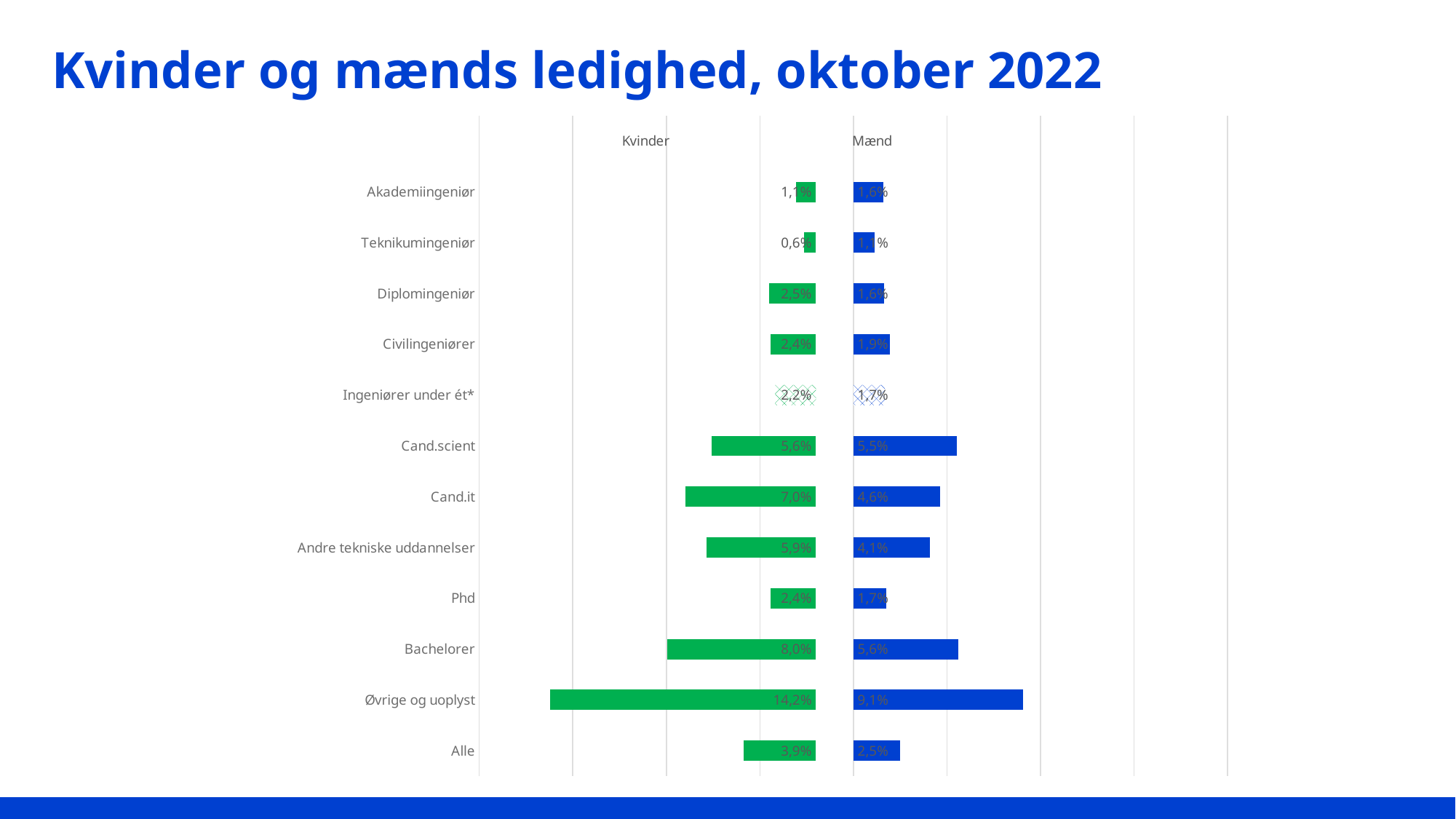
What is the difference between the Kvinder and Mænd values for Øvrige og uoplyst? 5,1 percentage points Which category has the lowest value for Kvinder? Teknikumingeniør What is the title of the slide? Kvinder og mænds ledighed, oktober 2022 What is the unemployment rate for Mænd in the Bachelorer category? 5,6% What is the value for Kvinder in the Cand.it category? 7,0% What is the value for Mænd in the Alle category? 2,5% What type of chart is shown on the slide? Bar chart Which is larger for Cand.it: the Kvinder value or the Mænd value? Kvinder How many categories are shown on the chart? 12 What is the unemployment rate for Kvinder in the Øvrige og uoplyst category? 14,2% Which category has the highest value for Kvinder? Øvrige og uoplyst How many series does the chart show? 2